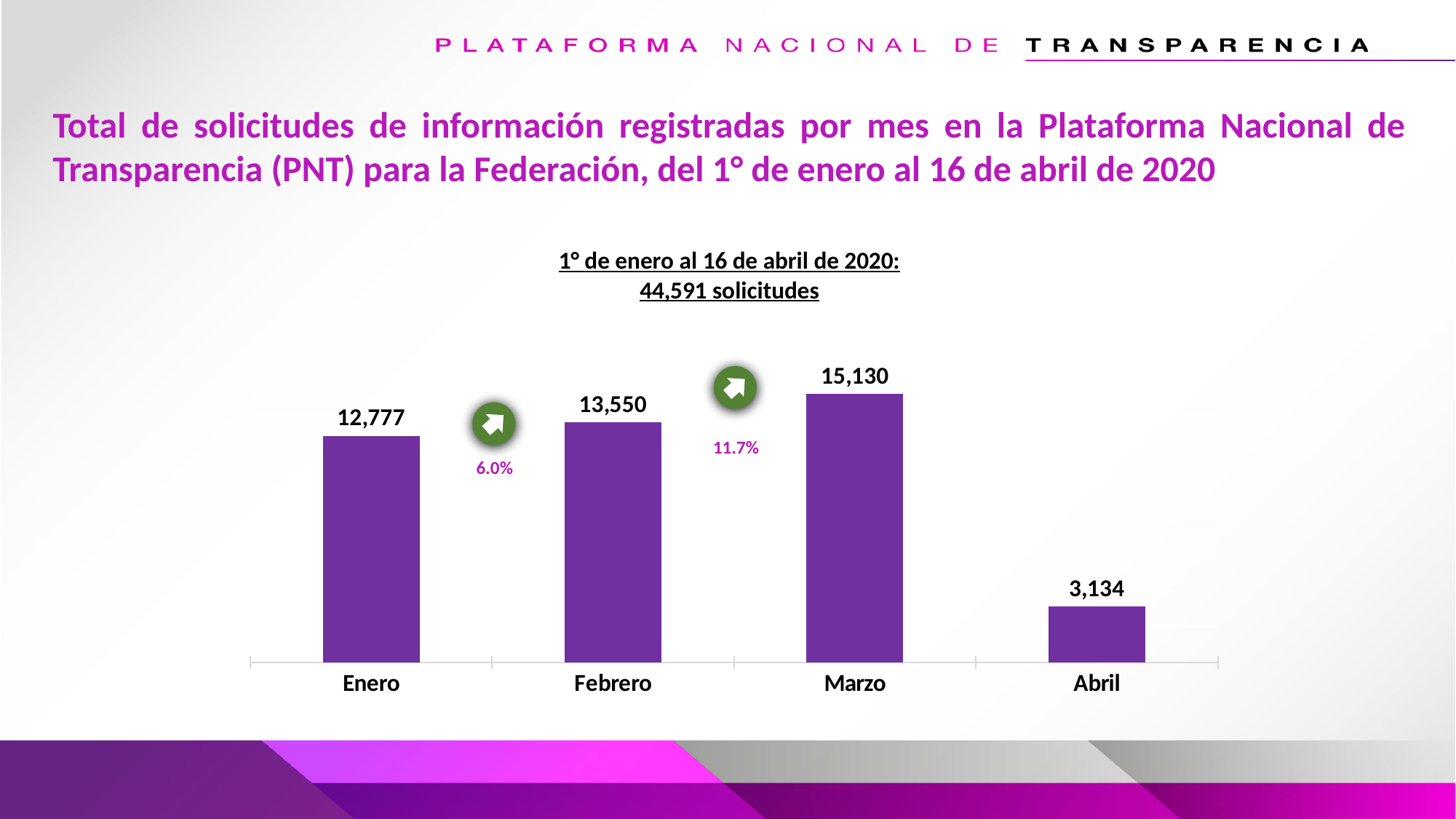
What percentage increase is shown between Febrero and Marzo? 11.7% Which month has the highest value? Marzo Which is larger, the value for Enero or the value for Abril? Enero What is the difference between the values for Marzo and Febrero? 1,580 What is the value for Marzo? 15,130 What is the value for Enero? 12,777 What kind of chart is shown? Bar chart What is the value for Febrero? 13,550 What is the difference between the values for Febrero and Enero? 773 What is the value for Abril? 3,134 How many months are shown on the chart? 4 Which month has the lowest value? Abril